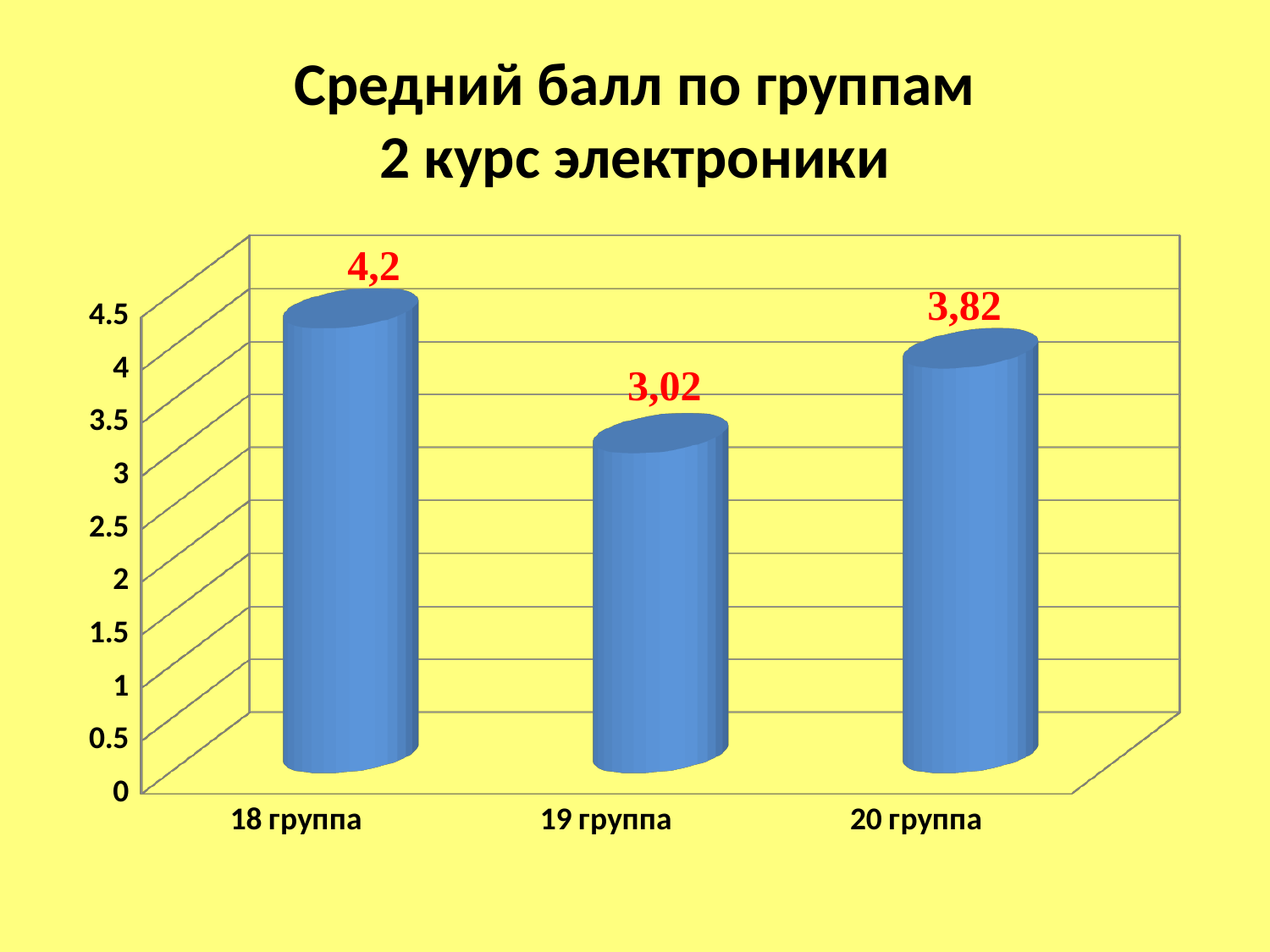
What is the title of the chart? Средний балл по группам 2 курс электроники Is the value for 19 группа greater or less than 3.5? less How many groups are shown on the chart? 3 What is the average score for 20 группа? 3,82 Which has a higher average score, 20 группа or 19 группа? 20 группа What is the difference between the average scores of 20 группа and 19 группа? 0,8 What is the difference between the average scores of 18 группа and 19 группа? 1,18 Which group has the lowest average score? 19 группа What kind of chart is shown on the slide? bar chart What is the average score for 18 группа? 4,2 What is the average score for 19 группа? 3,02 Which group has the highest average score? 18 группа